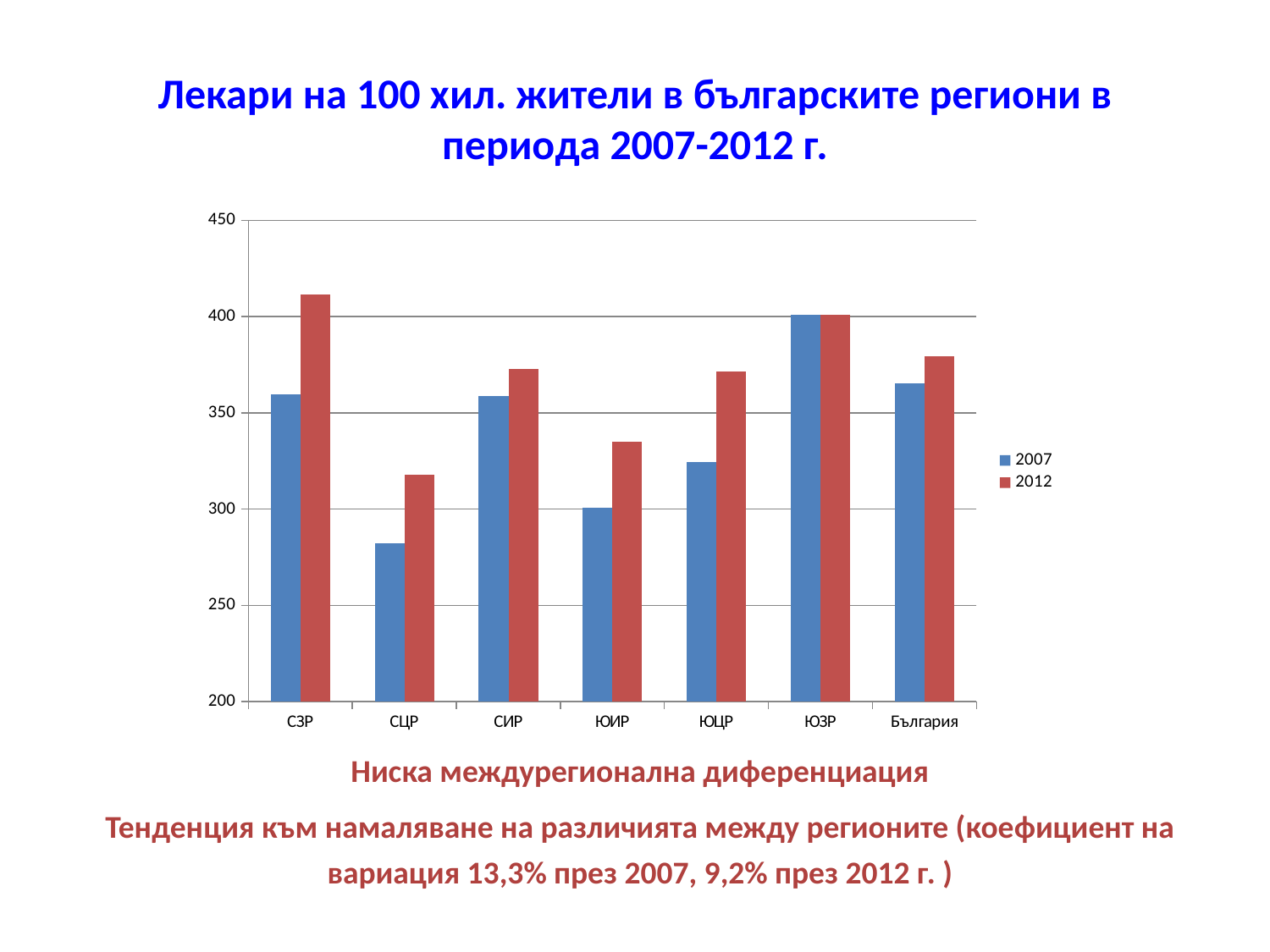
Is the value for СЗР in 2012 greater or less than 400? greater Is the value for ЮИР in 2012 greater or less than 350? less How many categories are shown on the x axis? 7 Which category has the lowest value for 2012? СЦР What kind of chart is shown on the slide? bar chart Which category has the lowest value for 2007? СЦР Is the value for ЮЦР in 2012 greater or less than 350? greater Which category has the highest value for 2007? ЮЗР How many series does the legend list? 2 For ЮЦР, which is larger: the 2007 value or the 2012 value? 2012 What are the two entries listed in the legend? 2007 and 2012